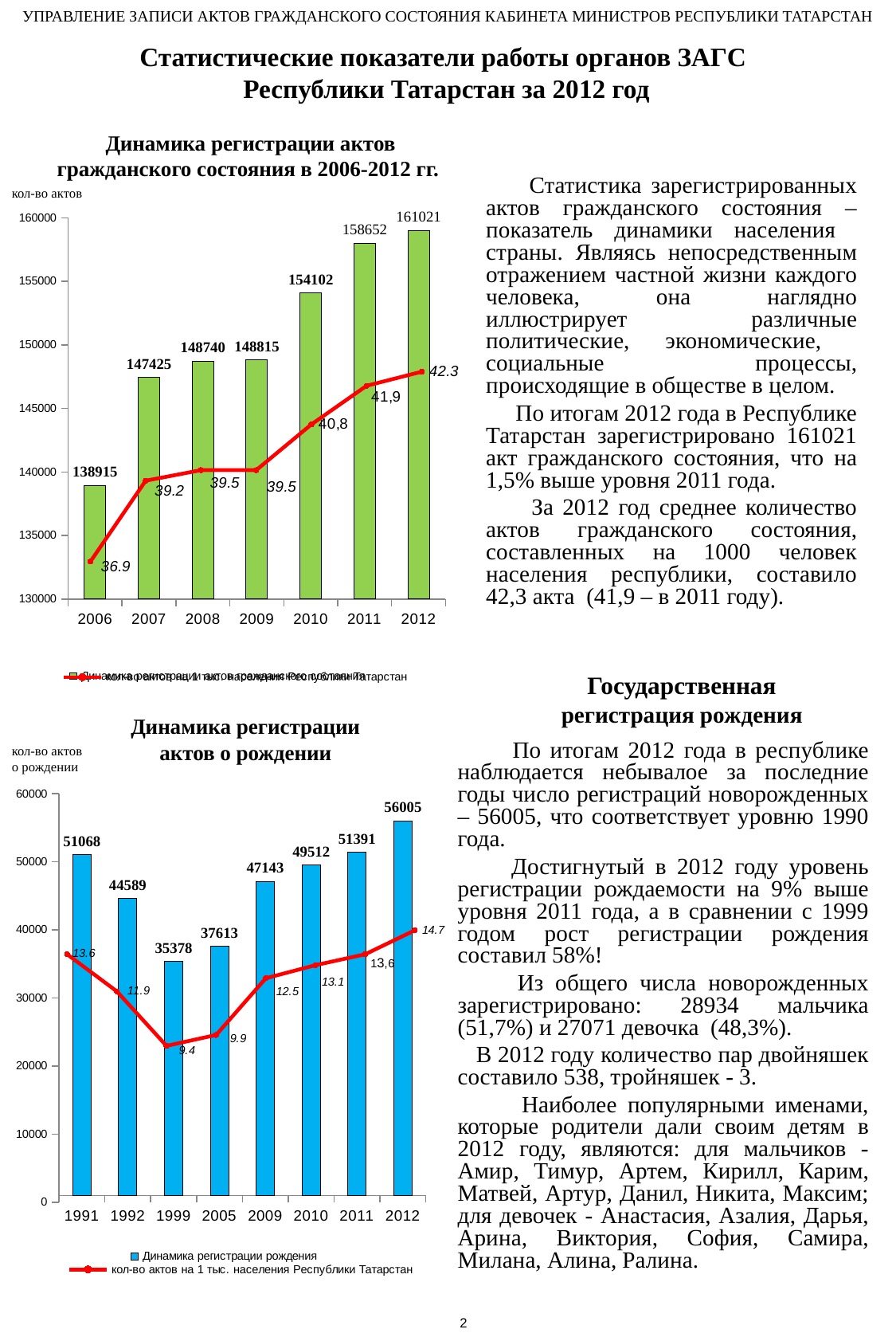
In the bottom chart (Динамика регистрации актов о рождении), which is larger: the value for 1991 or the value for 2011? 2011 In the top chart (Динамика регистрации актов гражданского состояния в 2006-2012 гг.), which year has the lowest number of registered acts? 2006 In the bottom chart (Динамика регистрации актов о рождении), what is the line value (acts per 1 thousand population) for 2012? 14.7 In the top chart (Динамика регистрации актов гражданского состояния в 2006-2012 гг.), how many years are shown on the x axis? 7 In the top chart (Динамика регистрации актов гражданского состояния в 2006-2012 гг.), what is the line value for 2010? 40,8 In the bottom chart (Динамика регистрации актов о рождении), which year has the highest number of birth registrations? 2012 In the top chart (Динамика регистрации актов гражданского состояния в 2006-2012 гг.), do the bar values rise or fall from 2006 to 2012? rise In the top chart (Динамика регистрации актов гражданского состояния в 2006-2012 гг.), what is the number of acts registered in 2012? 161021 In the bottom chart (Динамика регистрации актов о рождении), what is the number of birth registrations in 1999? 35378 In the bottom chart (Динамика регистрации актов о рождении), how many entries does the legend list? 2 What type of chart is the bottom chart (Динамика регистрации актов о рождении)? bar chart with a line In the top chart (Динамика регистрации актов гражданского состояния в 2006-2012 гг.), what is the difference between the number of acts in 2012 and in 2011? 2369